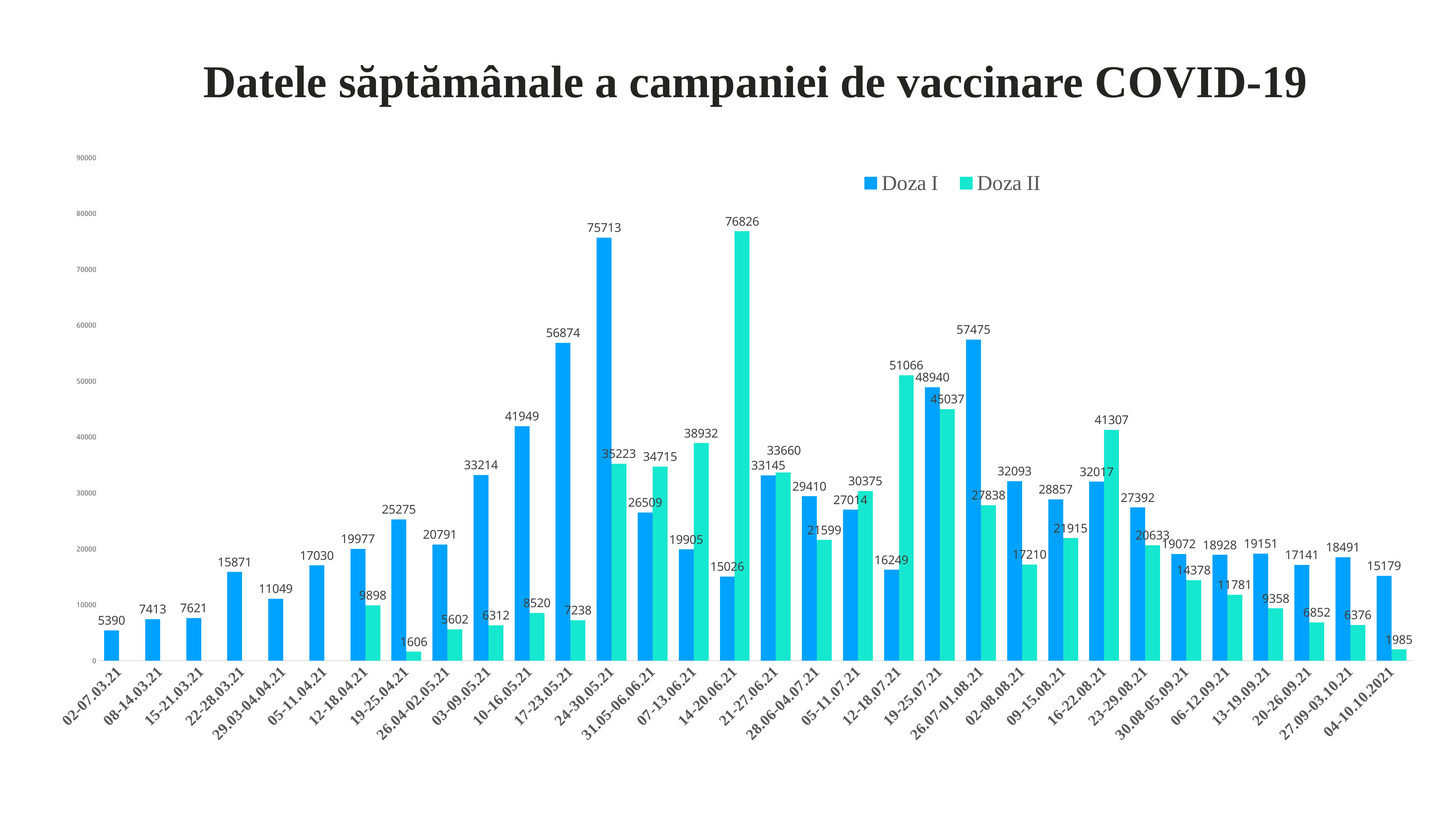
What is the title of the chart? Datele săptămânale a campaniei de vaccinare COVID-19 How many weekly categories are shown on the x axis? 32 What type of chart is shown on the slide? Bar chart In the week 12-18.07.21, which is larger, Doza I or Doza II? Doza II What is the Doza I value for the week 24-30.05.21? 75713 What is the difference between Doza I and Doza II in the week 24-30.05.21? 40490 What is the Doza II value for the week 14-20.06.21? 76826 How many series does the legend list? 2 Which week has the highest Doza I value? 24-30.05.21 What is the Doza I value for the week 02-07.03.21? 5390 Which week has the lowest Doza II value? 19-25.04.21 Which week has the highest Doza II value? 14-20.06.21